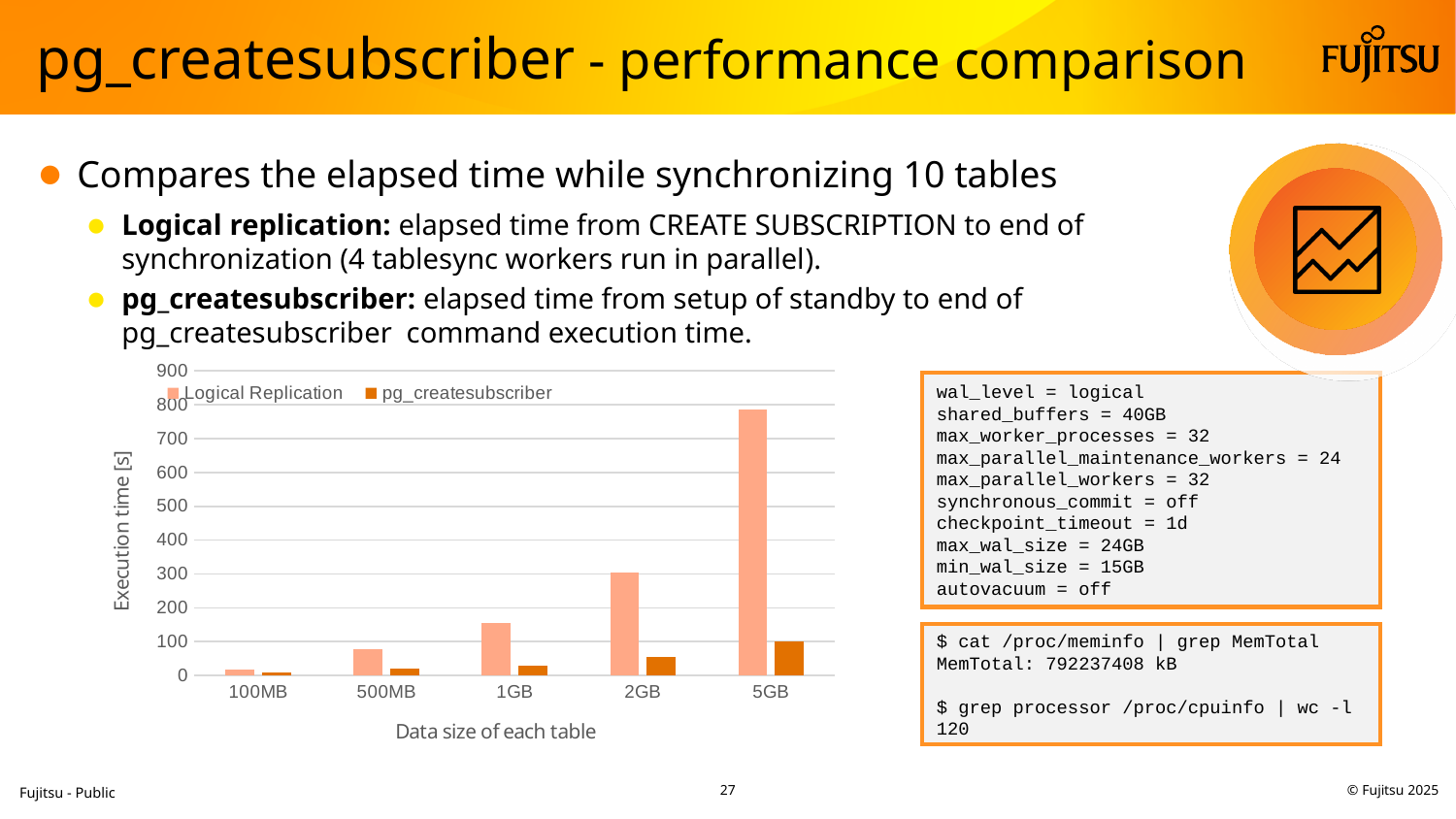
For which data size is the Logical Replication execution time lowest? 100MB Is the Logical Replication value for 5GB greater or less than 700? greater How many data size categories are shown on the x axis? 5 Is the Logical Replication value for 1GB greater or less than 100? greater Do the Logical Replication execution times rise or fall as the data size increases along the x axis? rise Is the pg_createsubscriber value for 5GB greater or less than 200? less At 5GB, which series has the larger execution time, Logical Replication or pg_createsubscriber? Logical Replication How many series does the chart legend list? 2 For which data size is the Logical Replication execution time highest? 5GB What kind of chart is shown on the slide? bar chart What is the label of the chart's y axis? Execution time [s]